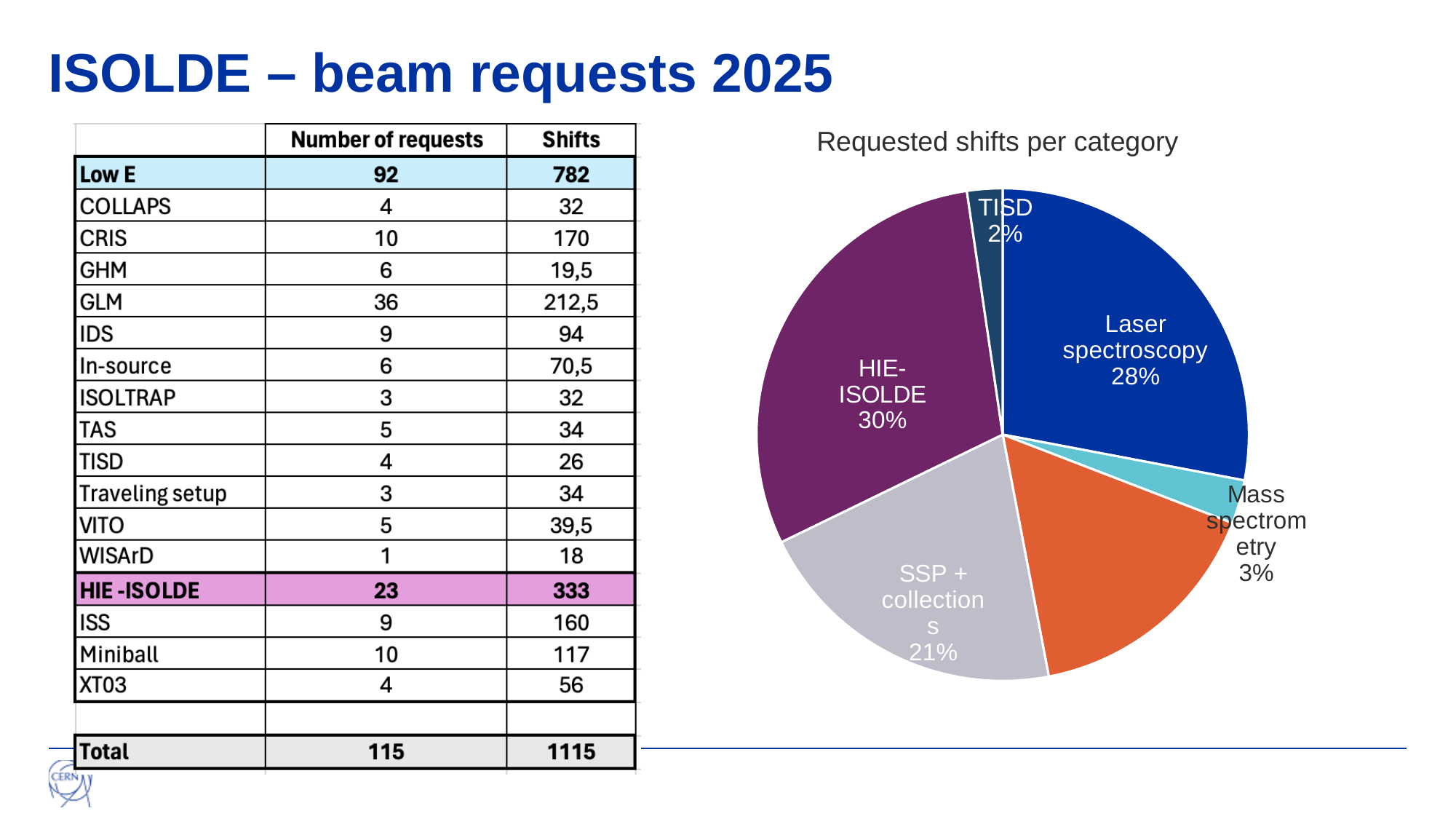
What percentage is shown for Mass spectrometry in the pie chart? 3% How many slices does the pie chart have? 6 Which labelled category has the smallest share in the pie chart? TISD What percentage is shown for SSP + collections in the pie chart? 21% What share of requested shifts does HIE-ISOLDE account for in the pie chart? 30% What is the difference in percentage points between HIE-ISOLDE and SSP + collections in the pie chart? 9 Which labelled category has the largest share in the pie chart? HIE-ISOLDE What percentage is shown for Laser spectroscopy in the pie chart? 28% Which has a larger share in the pie chart, Laser spectroscopy or Mass spectrometry? Laser spectroscopy What is the title of the pie chart? Requested shifts per category What percentage is shown for TISD in the pie chart? 2% What kind of chart is shown on the slide? pie chart